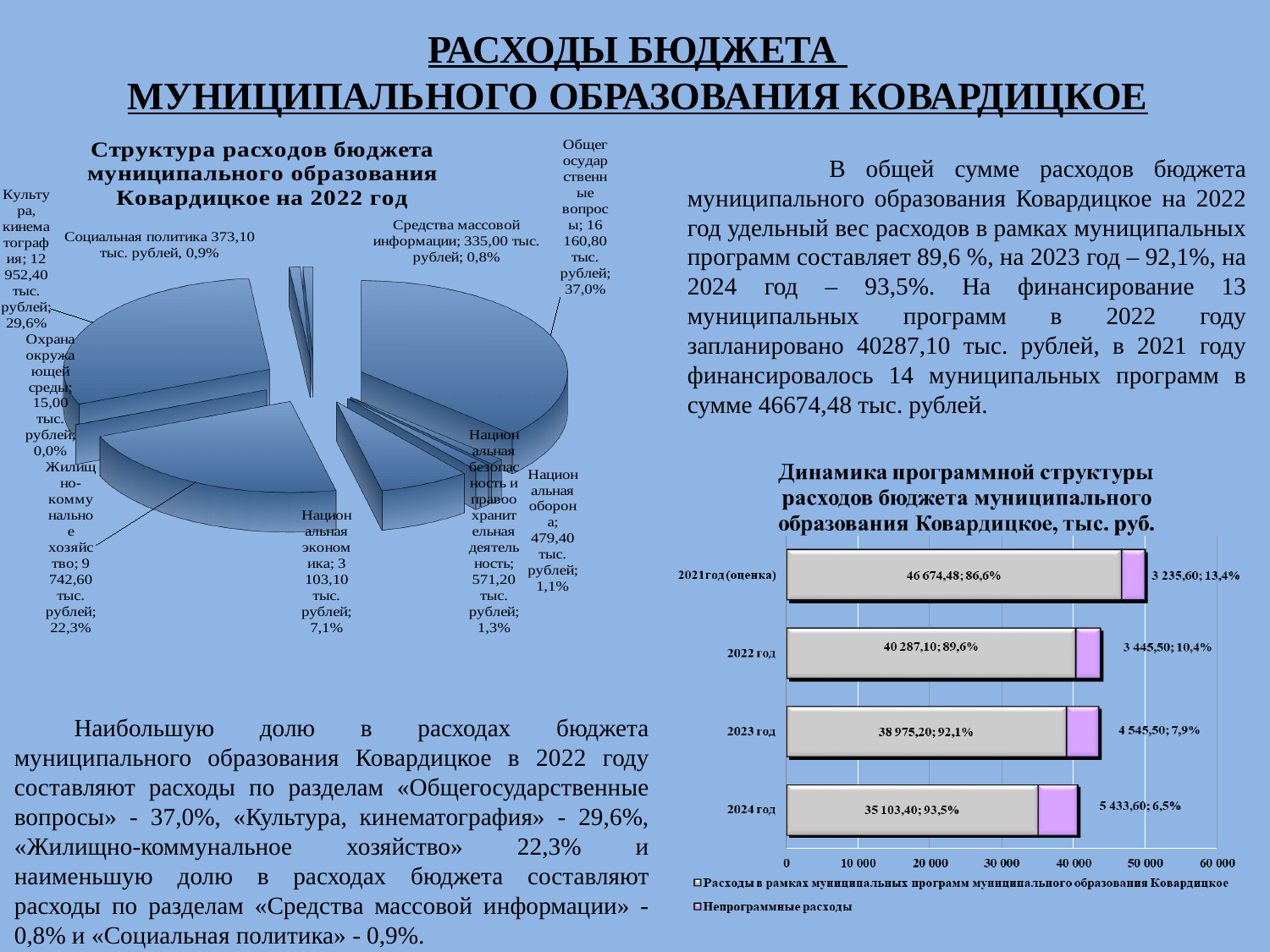
In the pie chart on the left, which is larger: 'Национальная оборона' or 'Национальная безопасность и правоохранительная деятельность'? Национальная безопасность и правоохранительная деятельность In the bar chart on the right, what is the difference between the program expenditures for 2021 год (оценка) and 2024 год? 11 571,08 In the pie chart on the left, what amount is shown for 'Жилищно-коммунальное хозяйство'? 9 742,60 тыс. рублей In the bar chart on the right, what is the total of the stacked bar for 2022 год? 43 732,60 In the pie chart 'Структура расходов бюджета муниципального образования Ковардицкое на 2022 год', what share is shown for 'Общегосударственные вопросы'? 37,0% In the bar chart 'Динамика программной структуры расходов бюджета муниципального образования Ковардицкое, тыс. руб.', what is the value of 'Расходы в рамках муниципальных программ' for 2023 год? 38 975,20 In the bar chart on the right, what is the value of 'Непрограммные расходы' for 2024 год? 5 433,60 In the pie chart on the left, which category has the largest share? Общегосударственные вопросы In the pie chart on the left, which category has the smallest share? Охрана окружающей среды How many series does the legend of the bar chart on the right list? 2 In the bar chart on the right, do the program expenditures rise or fall from 2021 год (оценка) to 2024 год? fall How many categories does the pie chart on the left show? 9